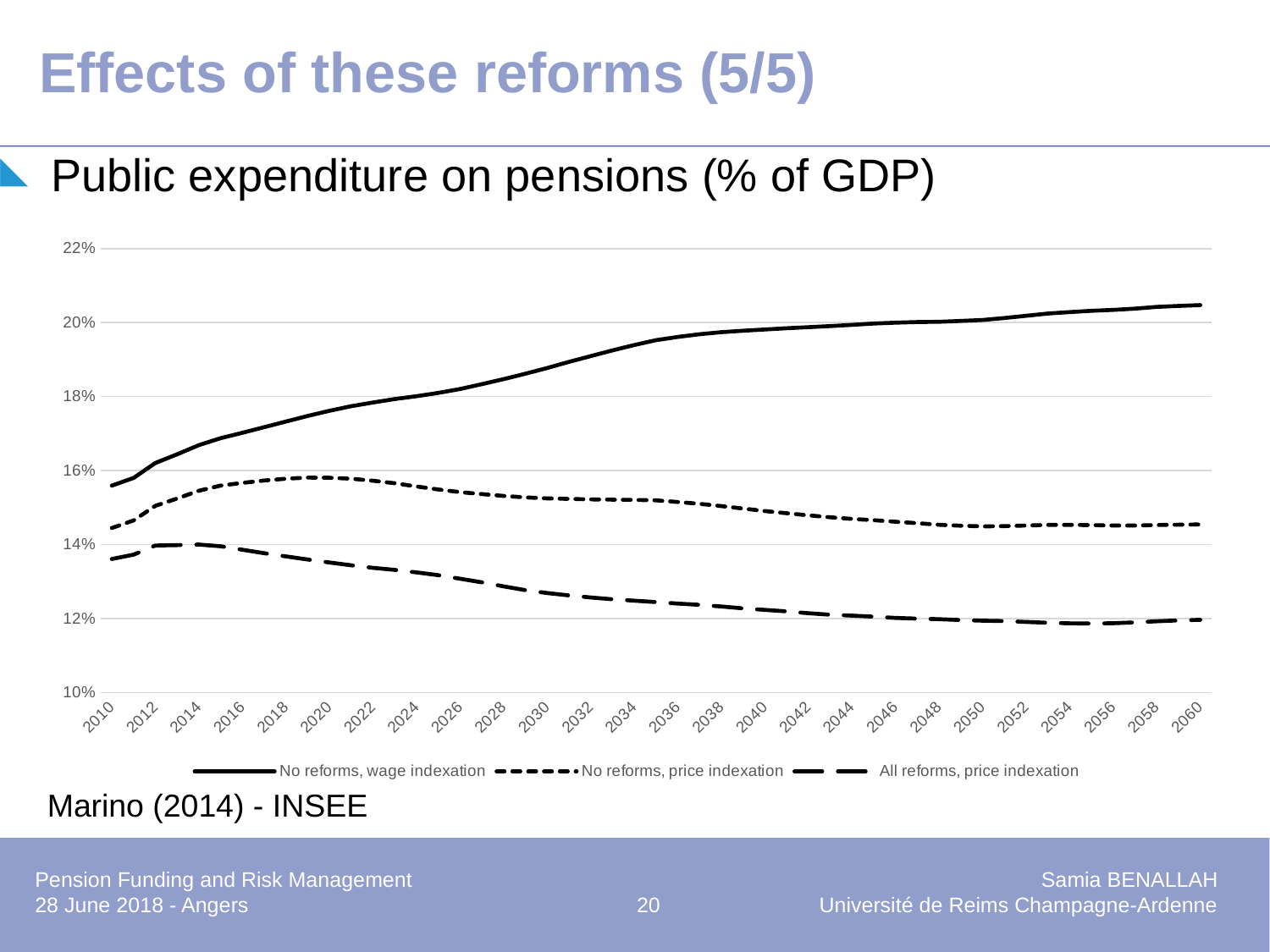
What kind of chart is shown on the slide? line chart Which series is drawn with a solid line? No reforms, wage indexation In 2060, which is larger: 'No reforms, price indexation' or 'All reforms, price indexation'? No reforms, price indexation How many series does the legend list? 3 Is the value for 'No reforms, wage indexation' in 2060 greater or less than 20%? greater Which series has the lowest value in 2040? All reforms, price indexation Does the 'No reforms, price indexation' series rise or fall from 2020 to 2050? fall Which series has the highest value in 2040? No reforms, wage indexation Does the 'No reforms, wage indexation' series rise or fall from 2010 to 2060? rise Is the value for 'All reforms, price indexation' in 2010 greater or less than 14%? less Does the 'All reforms, price indexation' series rise or fall from 2014 to 2050? fall What is the title of the chart? Public expenditure on pensions (% of GDP)